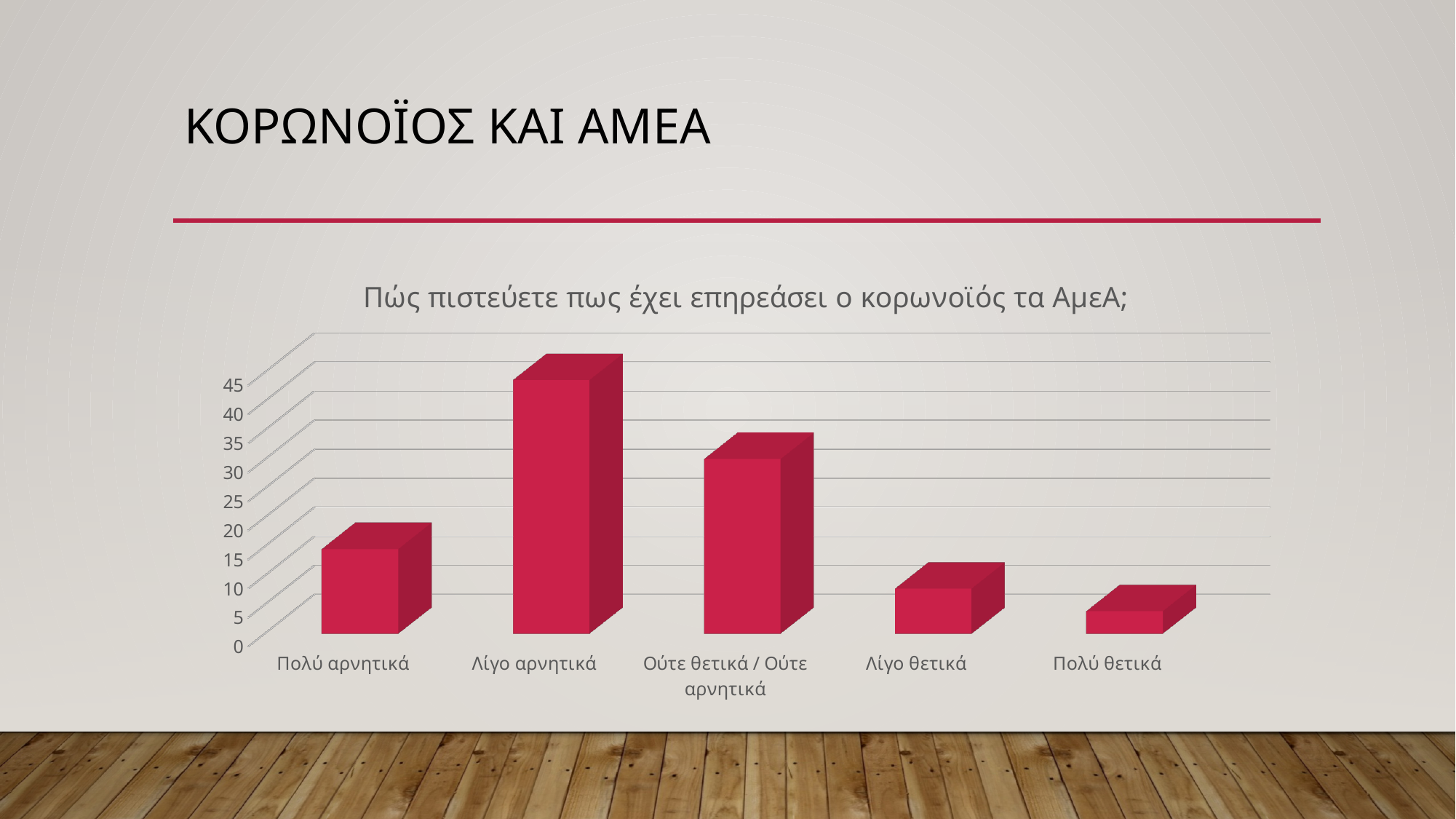
Which is larger, the value for Πολύ αρνητικά or the value for Λίγο θετικά? Πολύ αρνητικά Which is larger, the value for Ούτε θετικά / Ούτε αρνητικά or the value for Λίγο αρνητικά? Λίγο αρνητικά Is the value for Λίγο αρνητικά greater or less than 40? greater What kind of chart is shown on the slide? bar chart Is the value for Πολύ θετικά greater or less than 10? less Is the value for Λίγο θετικά greater or less than 20? less What is the title of the chart? Πώς πιστεύετε πως έχει επηρεάσει ο κορωνοϊός τα ΑμεΑ; Which category has the lowest bar? Πολύ θετικά How many categories are shown on the x axis of the chart? 5 Which category has the highest bar? Λίγο αρνητικά